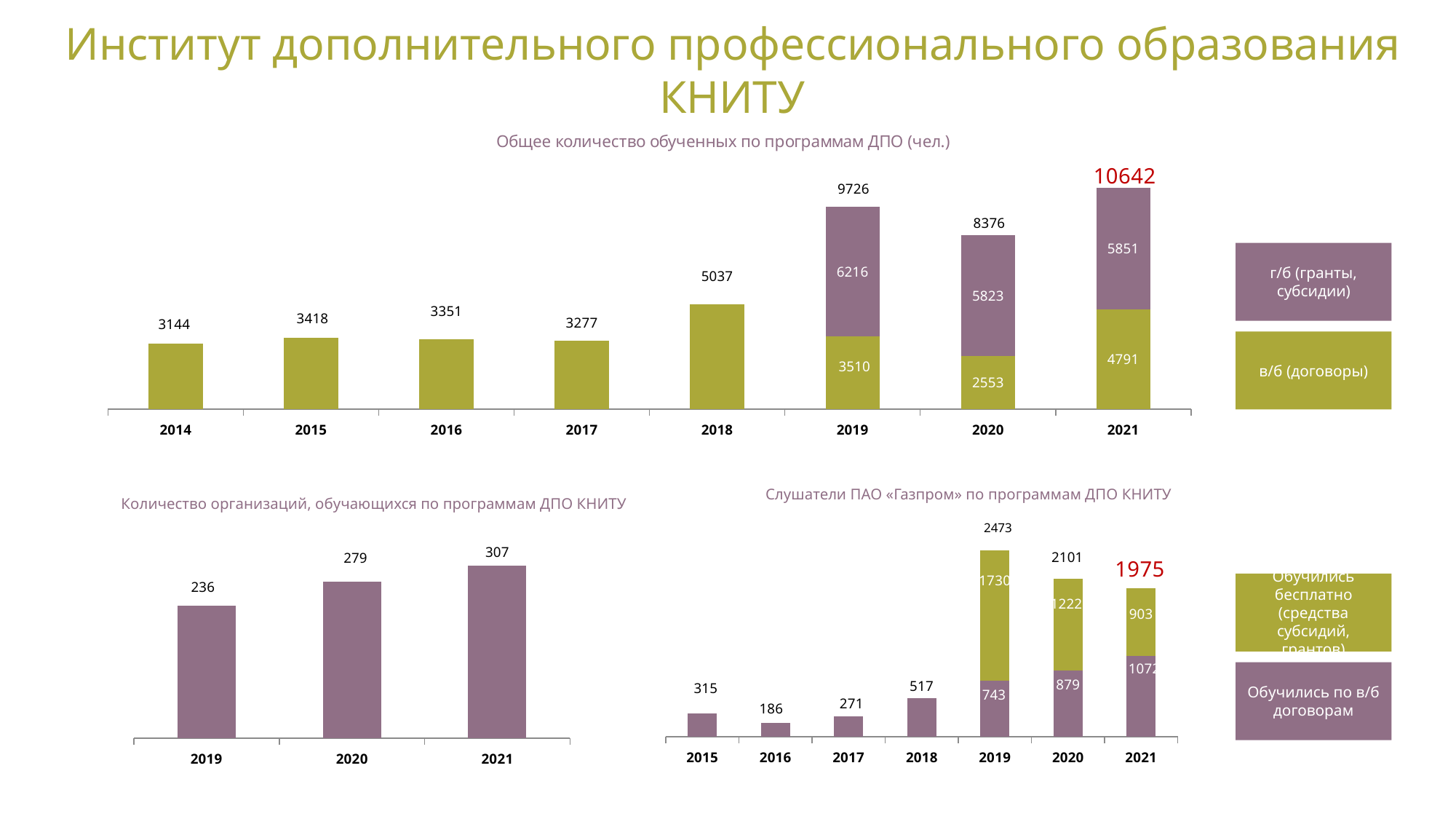
In the chart 'Общее количество обученных по программам ДПО (чел.)', how many years are shown on the x axis? 8 In the chart 'Количество организаций, обучающихся по программам ДПО КНИТУ', what is the value for 2020? 279 In the chart 'Общее количество обученных по программам ДПО (чел.)', what is the total value for 2021? 10642 In the chart 'Слушатели ПАО «Газпром» по программам ДПО КНИТУ', what is the value of the 'Обучились по в/б договорам' segment for 2021? 1072 In the chart 'Общее количество обученных по программам ДПО (чел.)', how many series does the legend list? 2 In the chart 'Слушатели ПАО «Газпром» по программам ДПО КНИТУ', which is larger, the value for 2016 or the value for 2017? 2017 In the chart 'Слушатели ПАО «Газпром» по программам ДПО КНИТУ', which year has the highest total? 2019 In the chart 'Общее количество обученных по программам ДПО (чел.)', which year has the lowest total? 2014 In the chart 'Количество организаций, обучающихся по программам ДПО КНИТУ', do the values rise or fall from 2019 to 2021? rise In the chart 'Общее количество обученных по программам ДПО (чел.)', what is the value of the 'в/б (договоры)' segment for 2019? 3510 In the chart 'Общее количество обученных по программам ДПО (чел.)', what is the difference between the totals for 2021 and 2020? 2266 What kind of chart is 'Количество организаций, обучающихся по программам ДПО КНИТУ'? bar chart